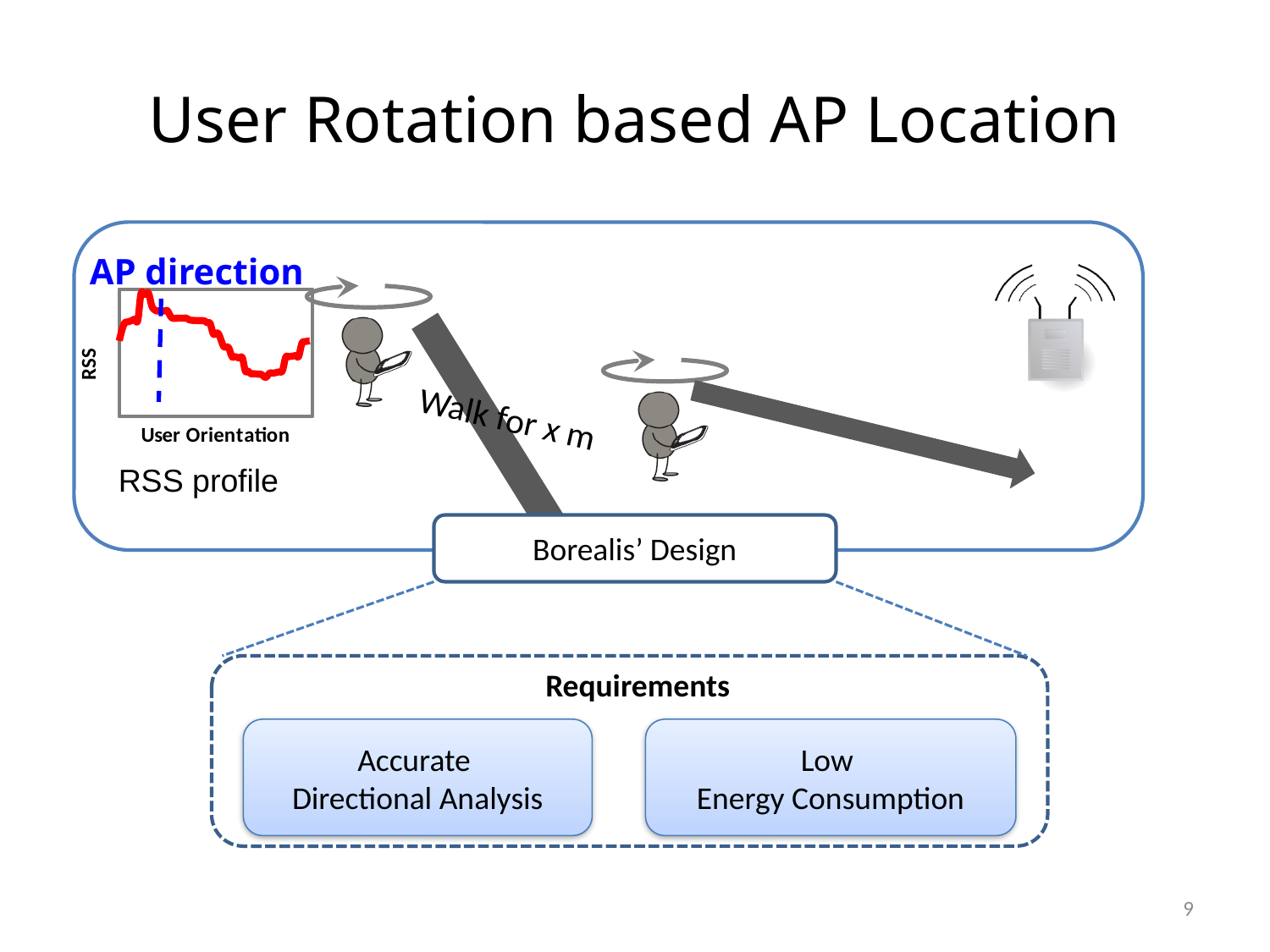
What kind of chart is the RSS profile chart on the slide? line chart In the RSS profile chart, is the peak of the RSS curve near the left or the right side of the chart? left How many lines (series) are plotted in the RSS profile chart? 1 In the RSS profile chart, does the RSS value rise or fall moving right from the dashed AP direction line toward the middle of the chart? fall What does the dashed vertical line in the RSS profile chart mark? AP direction What is the label of the x axis of the RSS profile chart? User Orientation